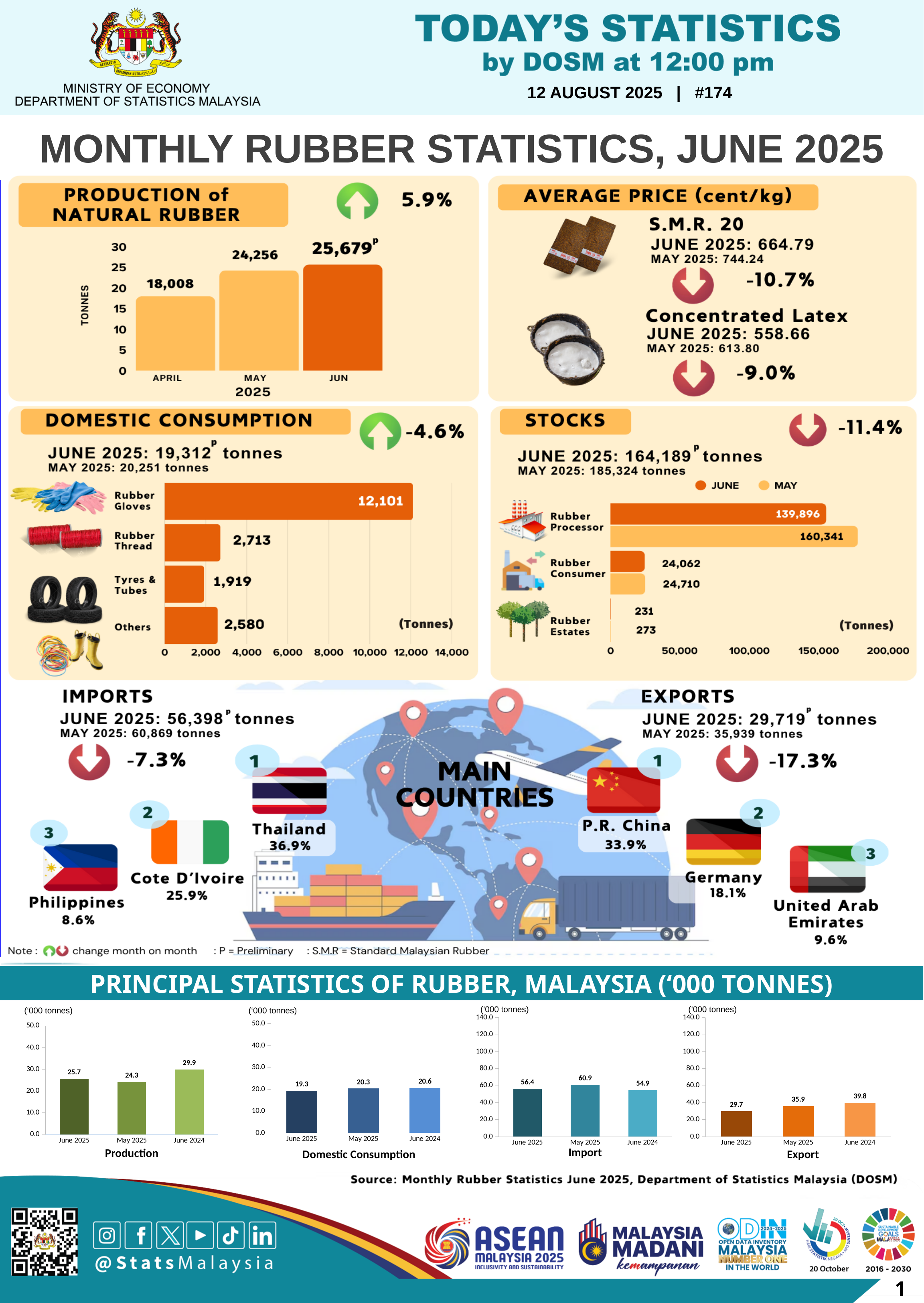
In the Stocks chart, what is the June value for Rubber Processor? 139,896 In the Export chart at the bottom of the slide, which period has the highest value? June 2024 In the Production of Natural Rubber chart, what is the difference between June and April production? 7,671 In the Production of Natural Rubber chart, what is the value for May? 24,256 In the Production of Natural Rubber chart, which month has the lowest production? April In the Stocks chart, how many series does the legend list? 2 In the Import chart at the bottom of the slide, what is the value for May 2025? 60.9 In the Domestic Consumption chart, which category has the highest value? Rubber Gloves In the Stocks chart, what is the difference between the May and June values for Rubber Consumer? 648 In the Domestic Consumption chart, which is larger: Others or Tyres & Tubes? Others In the Domestic Consumption chart, how many categories are shown? 4 In the Domestic Consumption chart, what is the value for Rubber Thread? 2,713